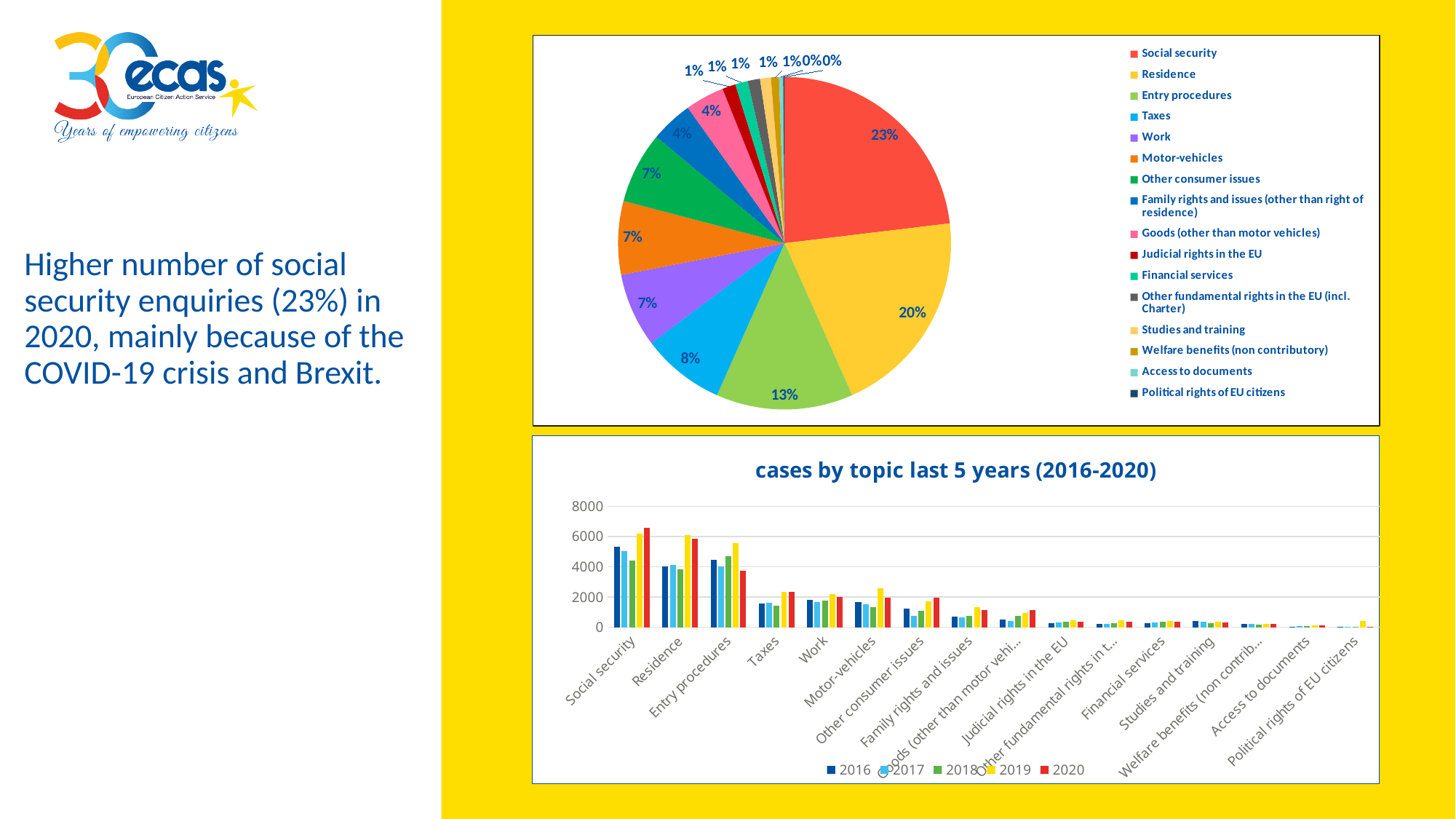
In the top pie chart, which category has the largest slice? Social security In the top pie chart, what share of enquiries is Taxes? 8% In the bottom chart 'cases by topic last 5 years (2016-2020)', how many series does the legend list? 5 In the top pie chart, how many categories does the legend list? 16 In the bottom chart 'cases by topic last 5 years (2016-2020)', which is larger for Entry procedures: the 2019 value or the 2020 value? 2019 What type of chart is the bottom chart titled 'cases by topic last 5 years (2016-2020)'? bar chart In the top pie chart, what is the difference in percentage points between Social security and Residence? 3 In the top pie chart, what share of enquiries is Social security? 23% In the top pie chart, what share of enquiries is Residence? 20% In the bottom chart 'cases by topic last 5 years (2016-2020)', is the value for Taxes in 2016 greater or less than 2000? less In the top pie chart, what share of enquiries is Entry procedures? 13% In the bottom chart 'cases by topic last 5 years (2016-2020)', is the value for Social security in 2020 greater or less than 6000? greater